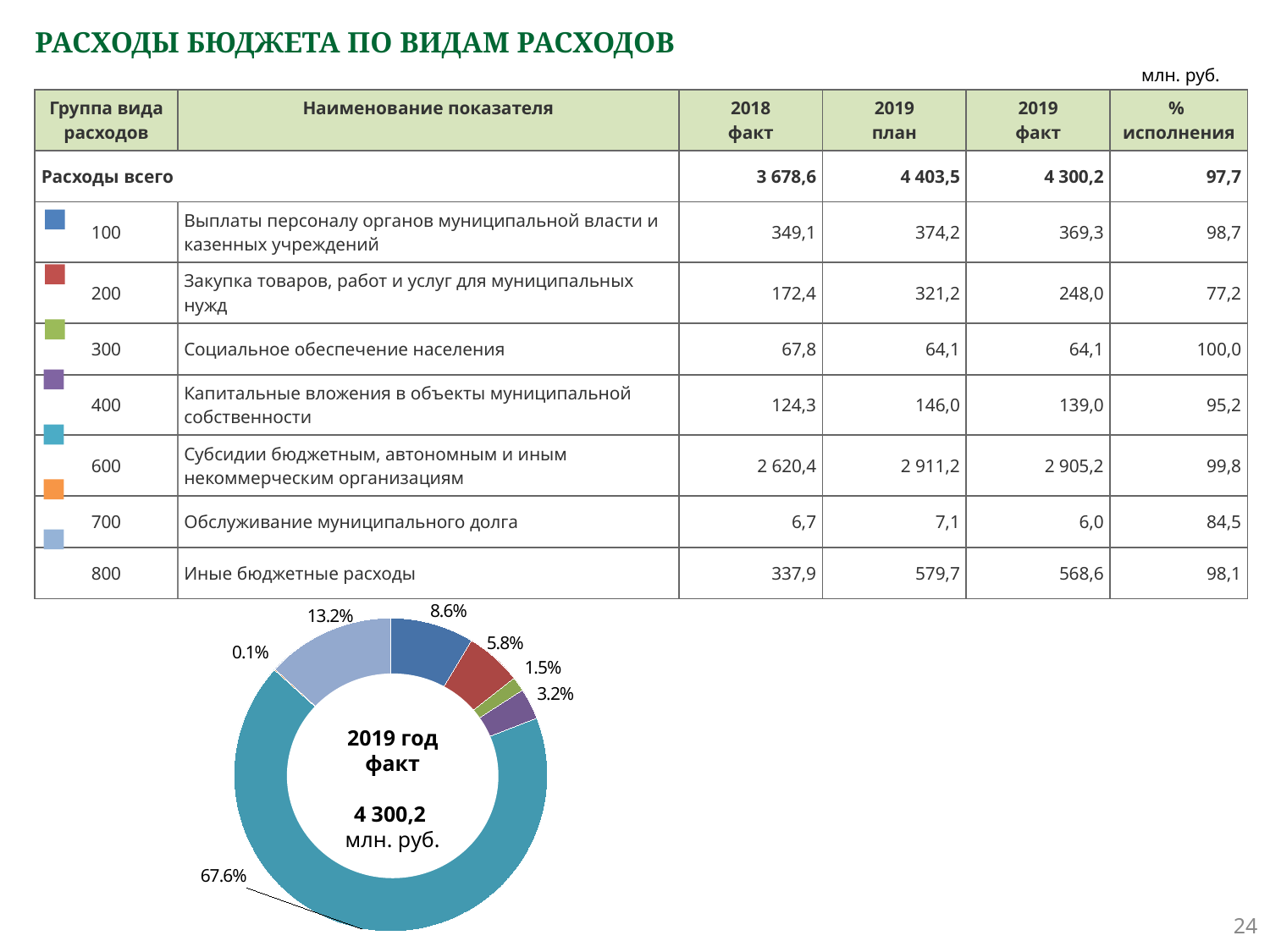
What total amount is shown in the centre of the donut chart? 4 300,2 млн. руб. In the donut chart, which is larger: the 5.8% slice or the 3.2% slice? The 5.8% slice What share is labelled on the purple slice of the donut chart? 3.2% What is the share of the largest slice in the donut chart? 67.6% What share is labelled on the light blue slice of the donut chart? 13.2% What is the share of the smallest slice in the donut chart? 0.1% What is the difference in percentage points between the 13.2% slice and the 8.6% slice in the donut chart? 4.6 percentage points What share is labelled on the red slice of the donut chart? 5.8% What share is labelled on the dark blue slice of the donut chart? 8.6% What type of chart is shown at the bottom of the slide? Pie chart (donut) Which year and data type does the donut chart represent, according to its centre label? 2019 год факт How many slices does the donut chart have? 7